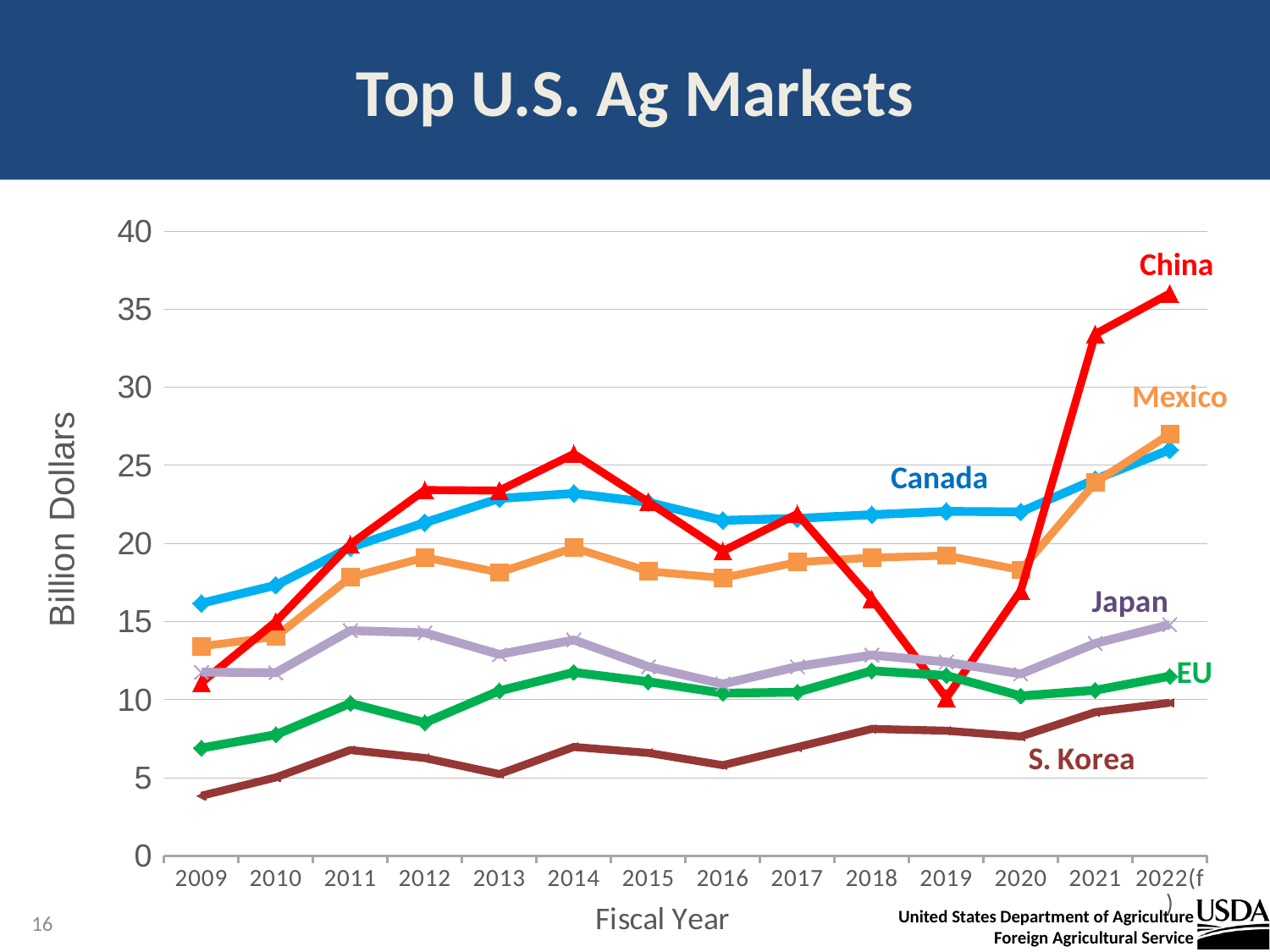
Which market has the highest value in 2009? Canada Is the value for S. Korea in 2009 greater or less than 5? less How many fiscal years are plotted along the x axis? 14 How many country series are labeled on the chart? 6 Which market has the highest value in 2022(f)? China What kind of chart is shown on the slide? line chart Is the value for China in 2022(f) greater or less than 30? greater Is the value for Mexico in 2022(f) greater or less than 25? greater What is the title of the y axis? Billion Dollars In 2019, which is larger, the value for Canada or the value for China? Canada Does the S. Korea line generally rise or fall from 2009 to 2022(f)? rise Which market has the lowest value in 2022(f)? S. Korea